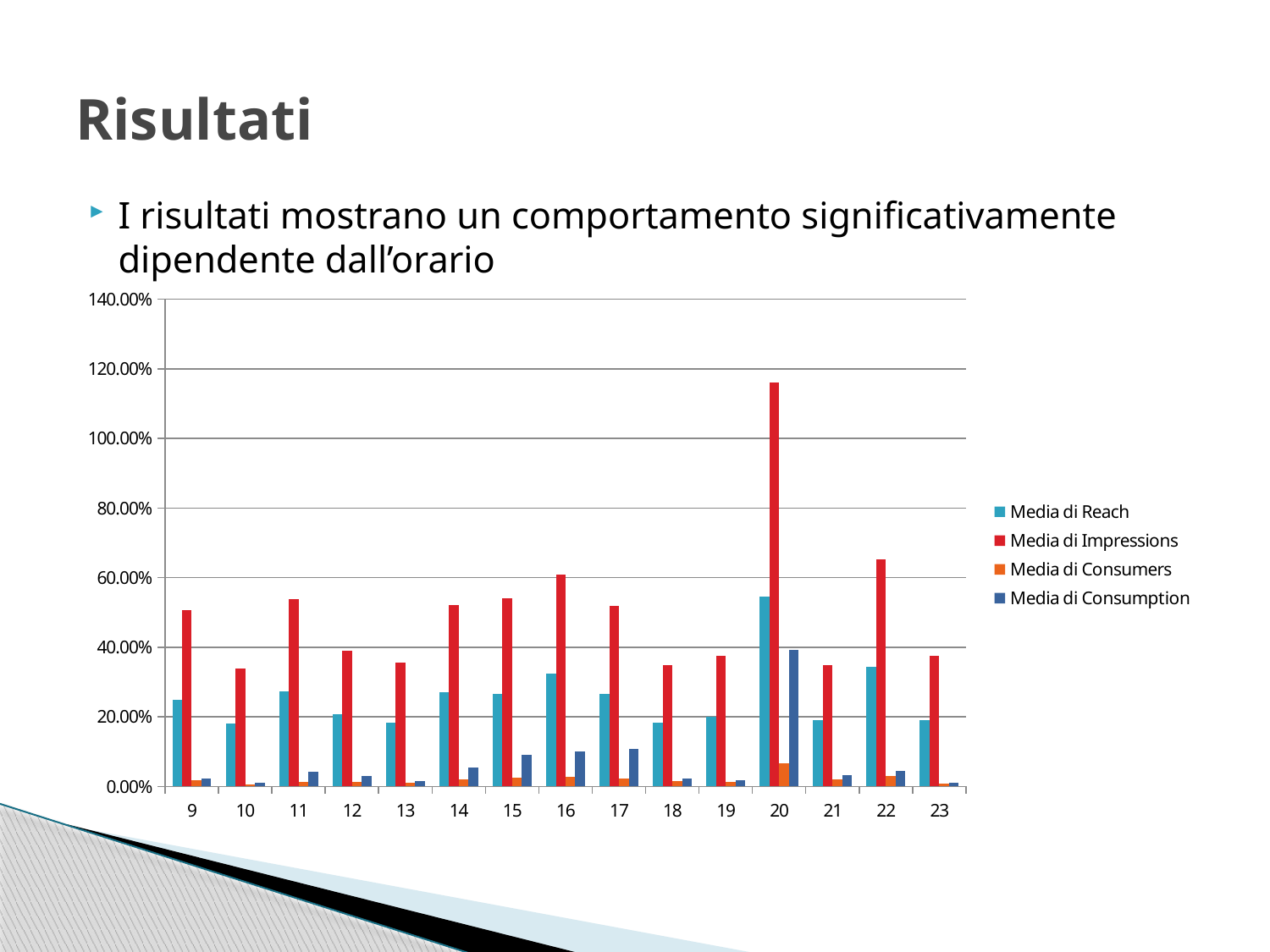
At which hour is the Media di Consumption value highest? 20 Is the Media di Reach value at hour 20 greater or less than 40.00%? greater Is the Media di Impressions value at hour 20 greater or less than 100.00%? greater Is the Media di Impressions value at hour 10 greater or less than 40.00%? less Which is larger, the Media di Impressions value at hour 22 or at hour 11? hour 22 How many hour categories are shown on the x axis of the chart? 15 At which hour is the Media di Reach value highest? 20 Which is larger, the Media di Impressions value at hour 16 or at hour 14? hour 16 At which hour is the Media di Impressions value highest? 20 What kind of chart is shown on the slide? bar chart Which series is shown in red in the chart's legend? Media di Impressions How many series does the chart's legend list? 4